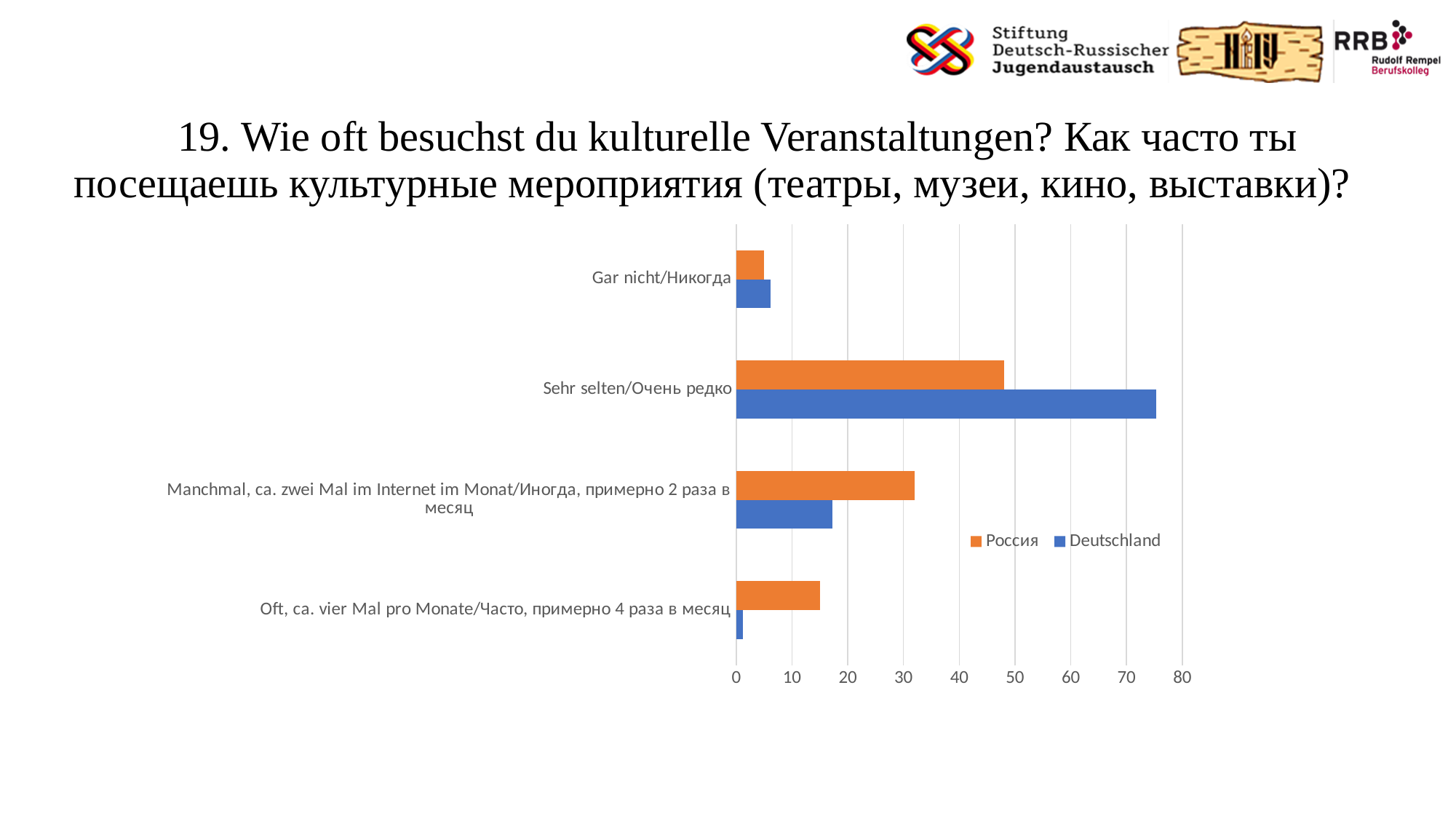
Is the Deutschland value for Oft, ca. vier Mal pro Monate/Часто, примерно 4 раза в месяц greater or less than 10? less Is the Deutschland value for Sehr selten/Очень редко greater or less than 70? greater Which category has the highest value for Deutschland? Sehr selten/Очень редко How many categories are shown on the chart? 4 Which category has the lowest value for Россия? Gar nicht/Никогда What kind of chart is shown on the slide? Bar chart How many series does the legend list? 2 For Sehr selten/Очень редко, which series has the larger value, Россия or Deutschland? Deutschland Which category has the lowest value for Deutschland? Oft, ca. vier Mal pro Monate/Часто, примерно 4 раза в месяц For Manchmal, ca. zwei Mal im Internet im Monat/Иногда, примерно 2 раза в месяц, which series has the larger value, Россия or Deutschland? Россия Which category has the highest value for Россия? Sehr selten/Очень редко Which colour represents the Россия series in the chart? Orange